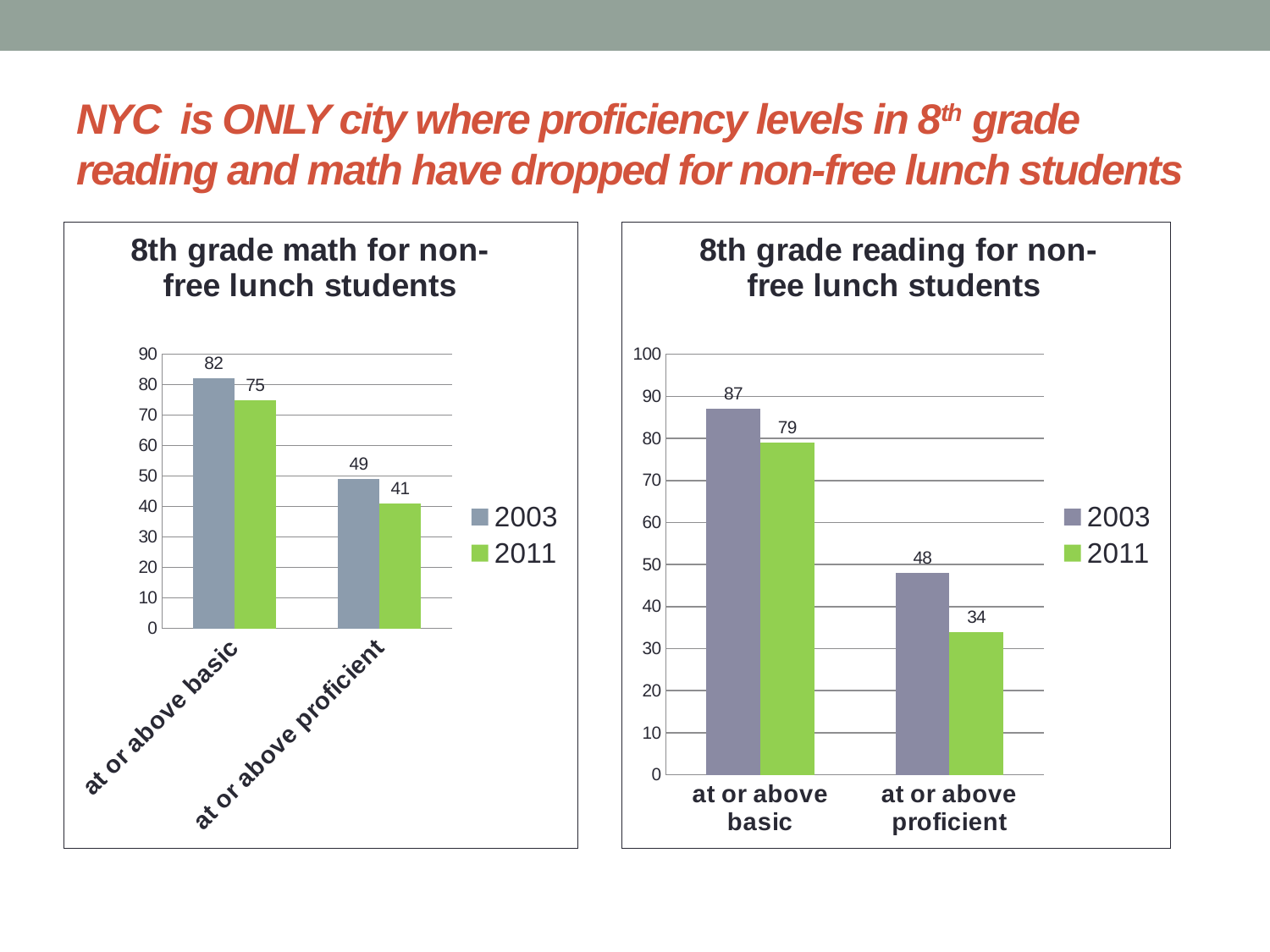
What kind of chart is the '8th grade reading for non-free lunch students' chart? Bar chart In the '8th grade math for non-free lunch students' chart, what is the 2003 value for 'at or above basic'? 82 In the '8th grade math for non-free lunch students' chart, what is the 2011 value for 'at or above proficient'? 41 In the '8th grade reading for non-free lunch students' chart, what is the 2003 value for 'at or above proficient'? 48 In the '8th grade math for non-free lunch students' chart, which bar is the lowest? 2011, at or above proficient In the '8th grade reading for non-free lunch students' chart, which bar is the highest? 2003, at or above basic How many series does the legend list in the '8th grade math for non-free lunch students' chart? 2 In the '8th grade reading for non-free lunch students' chart, which series has the larger value for 'at or above basic', 2003 or 2011? 2003 In the '8th grade reading for non-free lunch students' chart, what is the difference between the 2003 and 2011 values for 'at or above proficient'? 14 How many categories are shown on the x axis of the '8th grade reading for non-free lunch students' chart? 2 In the '8th grade reading for non-free lunch students' chart, what is the 2011 value for 'at or above basic'? 79 In the '8th grade math for non-free lunch students' chart, what is the difference between the 2003 and 2011 values for 'at or above basic'? 7